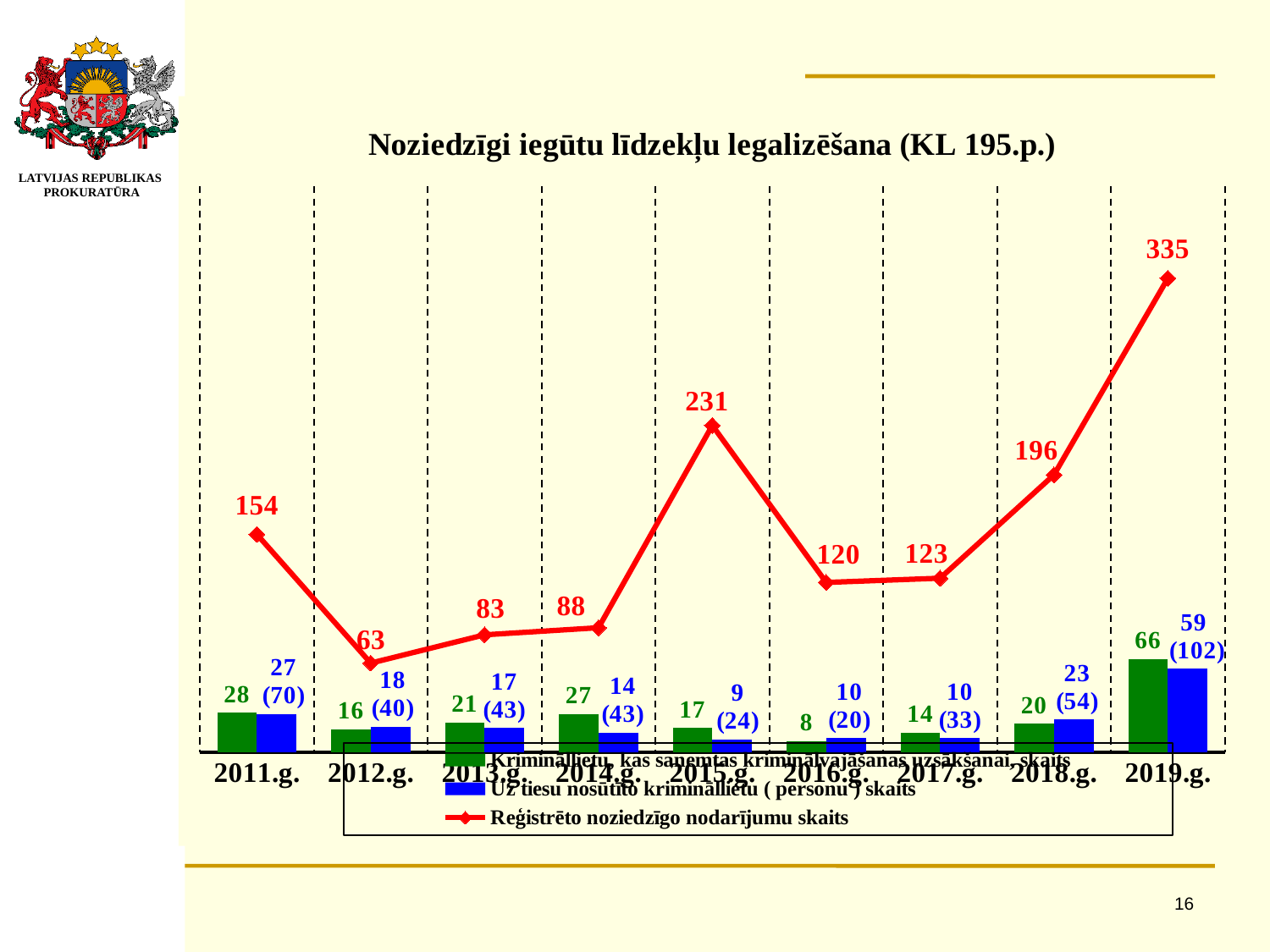
What is the value of the green bar (Krimināllietu, kas saņemtas kriminālvajāšanas uzsākšanai, skaits) for 2016.g.? 8 What is the value of the blue bar (Uz tiesu nosūtīto krimināllietu (personu) skaits) for 2018.g.? 23 (54) How many years are shown on the x axis? 9 What is the value of the red line (Reģistrēto noziedzīgo nodarījumu skaits) for 2019.g.? 335 In which year is the red line (Reģistrēto noziedzīgo nodarījumu skaits) lowest? 2012.g. Does the red line rise or fall from 2016.g. to 2019.g.? rise What is the title of the chart? Noziedzīgi iegūtu līdzekļu legalizēšana (KL 195.p.) How many series does the legend list? 3 Which is larger: the red line value for 2011.g. or for 2016.g.? 2011.g. In which year is the green bar (Krimināllietu, kas saņemtas kriminālvajāšanas uzsākšanai, skaits) highest? 2019.g. What is the value of the red line (Reģistrēto noziedzīgo nodarījumu skaits) for 2015.g.? 231 What is the difference between the red line values for 2019.g. and 2018.g.? 139